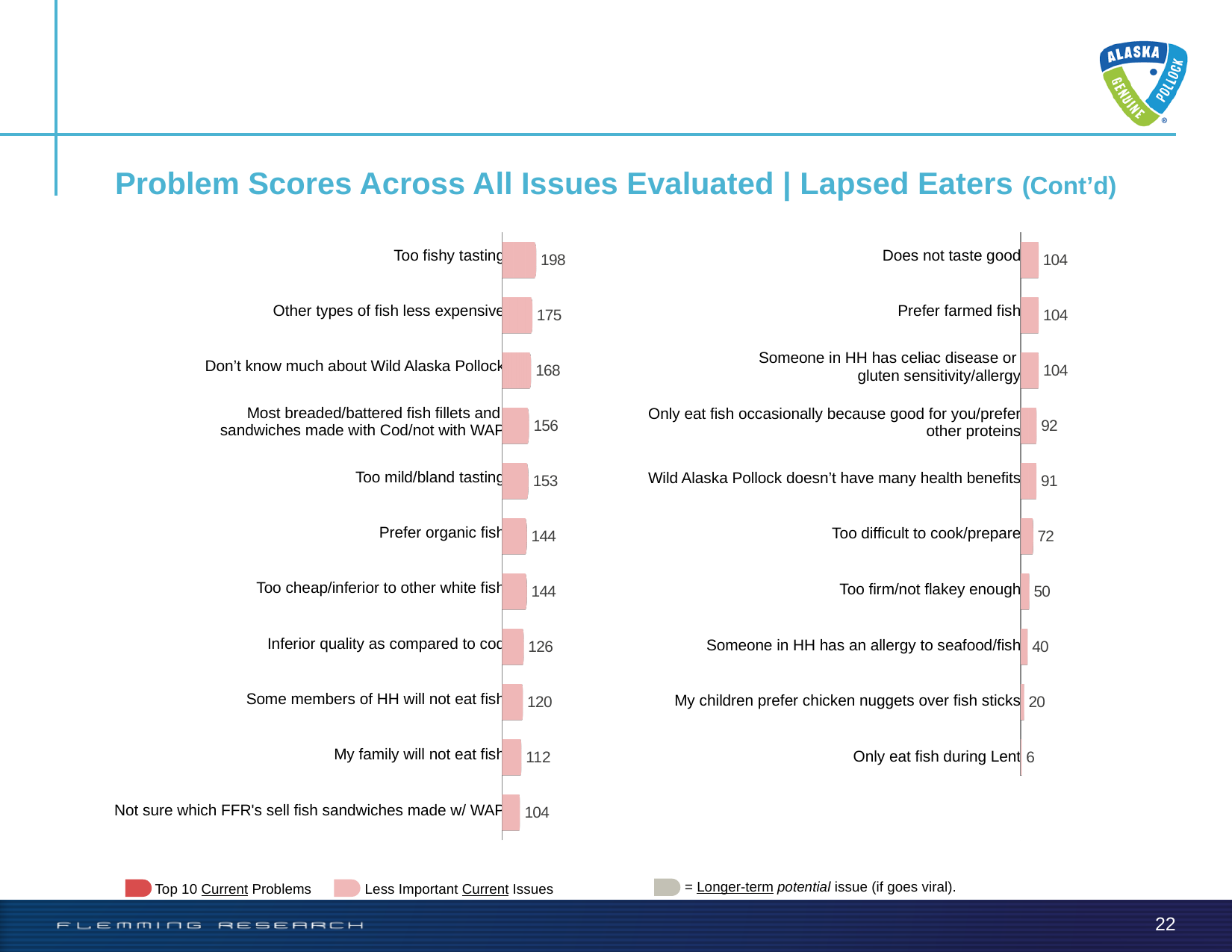
What type of chart is used on this slide? Bar chart On the left chart, which is larger: the value for "Inferior quality as compared to cod" or "Some members of HH will not eat fish"? Inferior quality as compared to cod On the left chart, what is the difference between the values for "Other types of fish less expensive" and "My family will not eat fish"? 63 On the right chart, what is the difference between "Too firm/not flakey enough" and "My children prefer chicken nuggets over fish sticks"? 30 On the right chart, which issue has the lowest value? Only eat fish during Lent On the left chart, what is the problem score for "Too fishy tasting"? 198 How many issues are plotted on the right chart? 10 On the right chart, what is the value for "Only eat fish during Lent"? 6 On the right chart, what is the value for "Too difficult to cook/prepare"? 72 On the left chart, which issue has the highest problem score? Too fishy tasting On the left chart, what is the value for "Too mild/bland tasting"? 153 How many issues are plotted on the left chart? 11